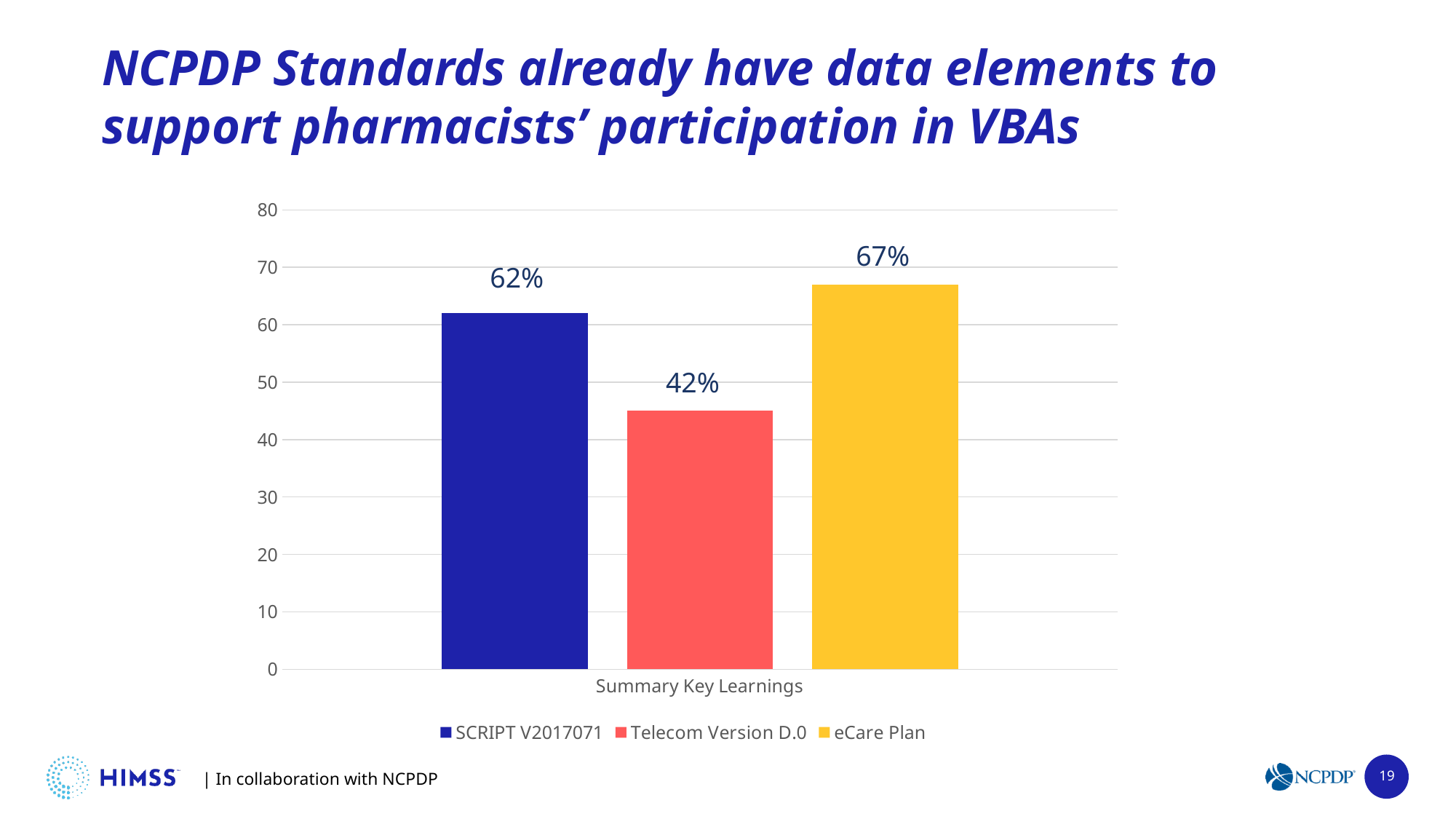
What is the value for Telecom Version D.0? 42% What is the difference between the eCare Plan value and the SCRIPT V2017071 value? 5% How many series does the legend list? 3 Is the value for eCare Plan greater or less than 60? greater What is the difference between the SCRIPT V2017071 value and the Telecom Version D.0 value? 20% Which series has the lowest value? Telecom Version D.0 What kind of chart is shown on the slide? Bar chart What is the category label shown on the x axis? Summary Key Learnings What is the value for eCare Plan? 67% What is the value for SCRIPT V2017071? 62% Which series has the highest value? eCare Plan Which is larger, the value for SCRIPT V2017071 or the value for Telecom Version D.0? SCRIPT V2017071